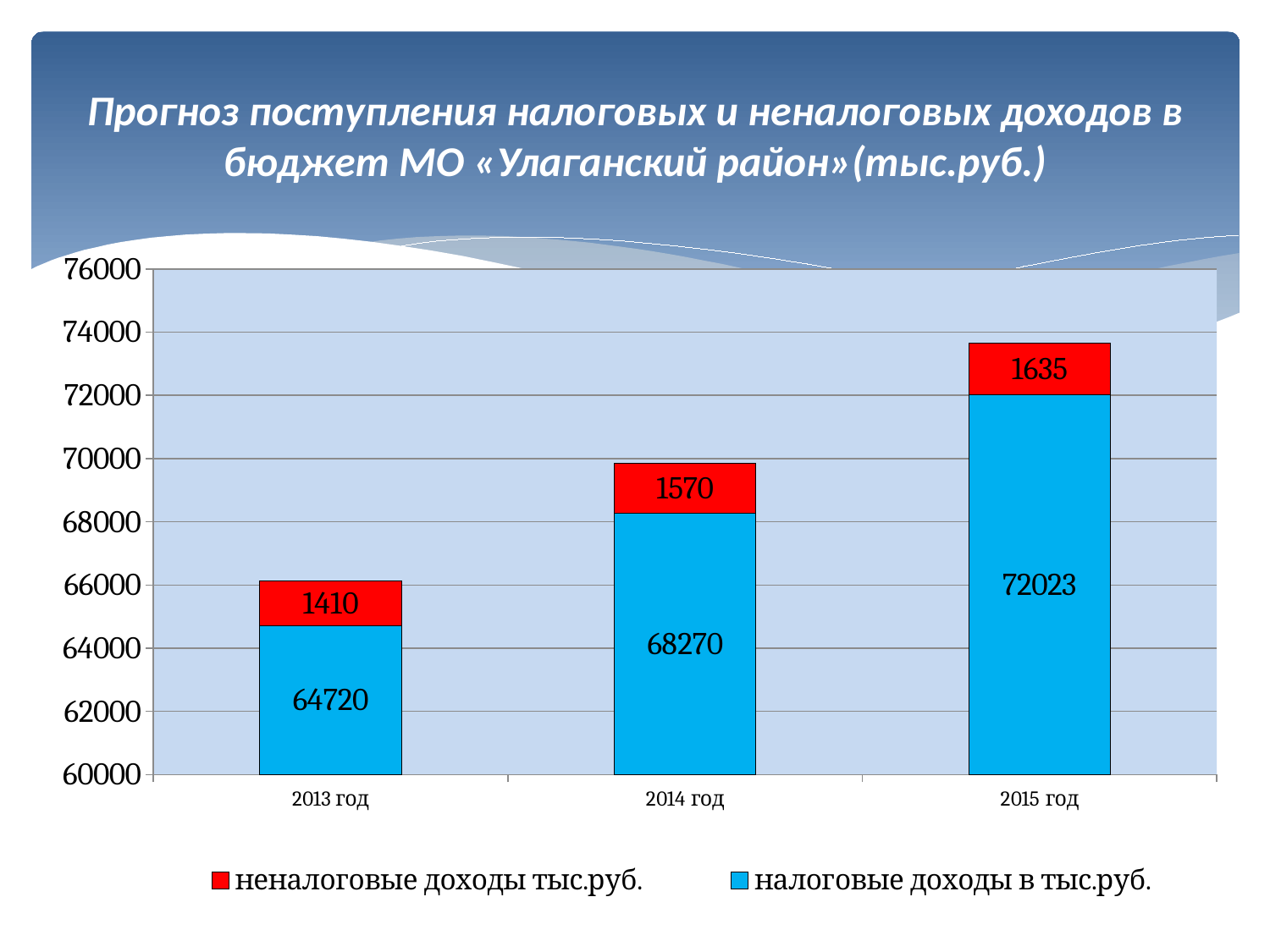
How many years are shown on the x axis? 3 Which year has the lowest value of неналоговые доходы? 2013 год What is the value of неналоговые доходы for 2013 год? 1410 Which year has the highest value of налоговые доходы? 2015 год What is the difference in налоговые доходы between 2015 год and 2013 год? 7303 Do the values of налоговые доходы rise or fall from 2013 год to 2015 год? Rise What is the difference in неналоговые доходы between 2014 год and 2013 год? 160 What is the value of неналоговые доходы for 2015 год? 1635 How many series does the legend list? 2 Which is larger: налоговые доходы in 2013 год or in 2014 год? 2014 год What is the value of налоговые доходы for 2014 год? 68270 What kind of chart is shown on the slide? Stacked bar chart